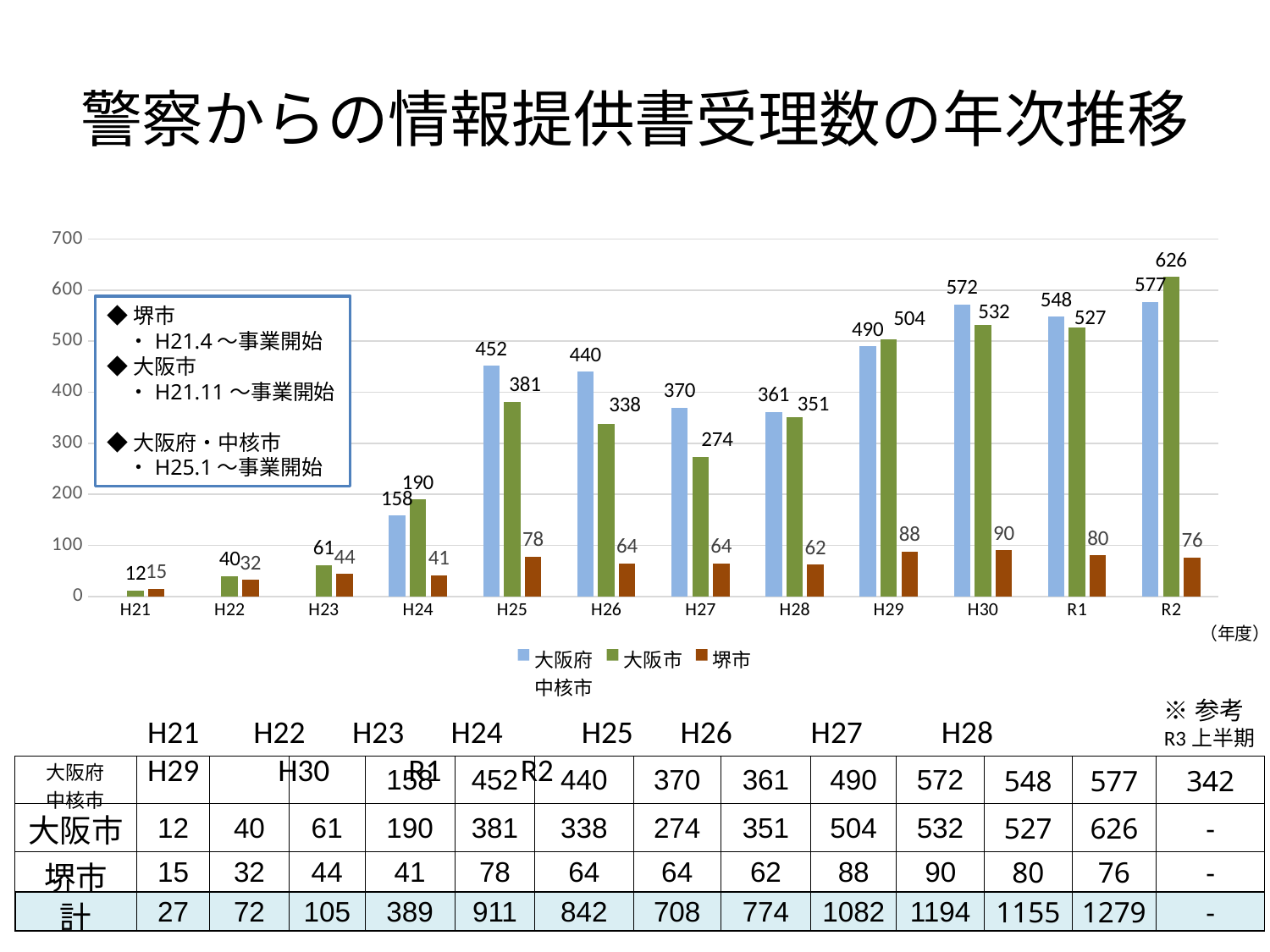
Which is larger in H29, 大阪府中核市 or 大阪市? 大阪市 Which series is drawn in green? 大阪市 Does the value for 大阪市 rise or fall from H21 to H25? rise What is the difference between 大阪府中核市 and 大阪市 in H27? 96 What is the value for 大阪市 in H25? 381 What is the value for 堺市 in H30? 90 In which year does 大阪市 reach its highest value? R2 How many years (categories) are shown on the x axis? 12 In which year is the value for 堺市 lowest? H21 What kind of chart is shown? bar chart What is the value for 大阪府中核市 in R1? 548 How many series does the legend list? 3